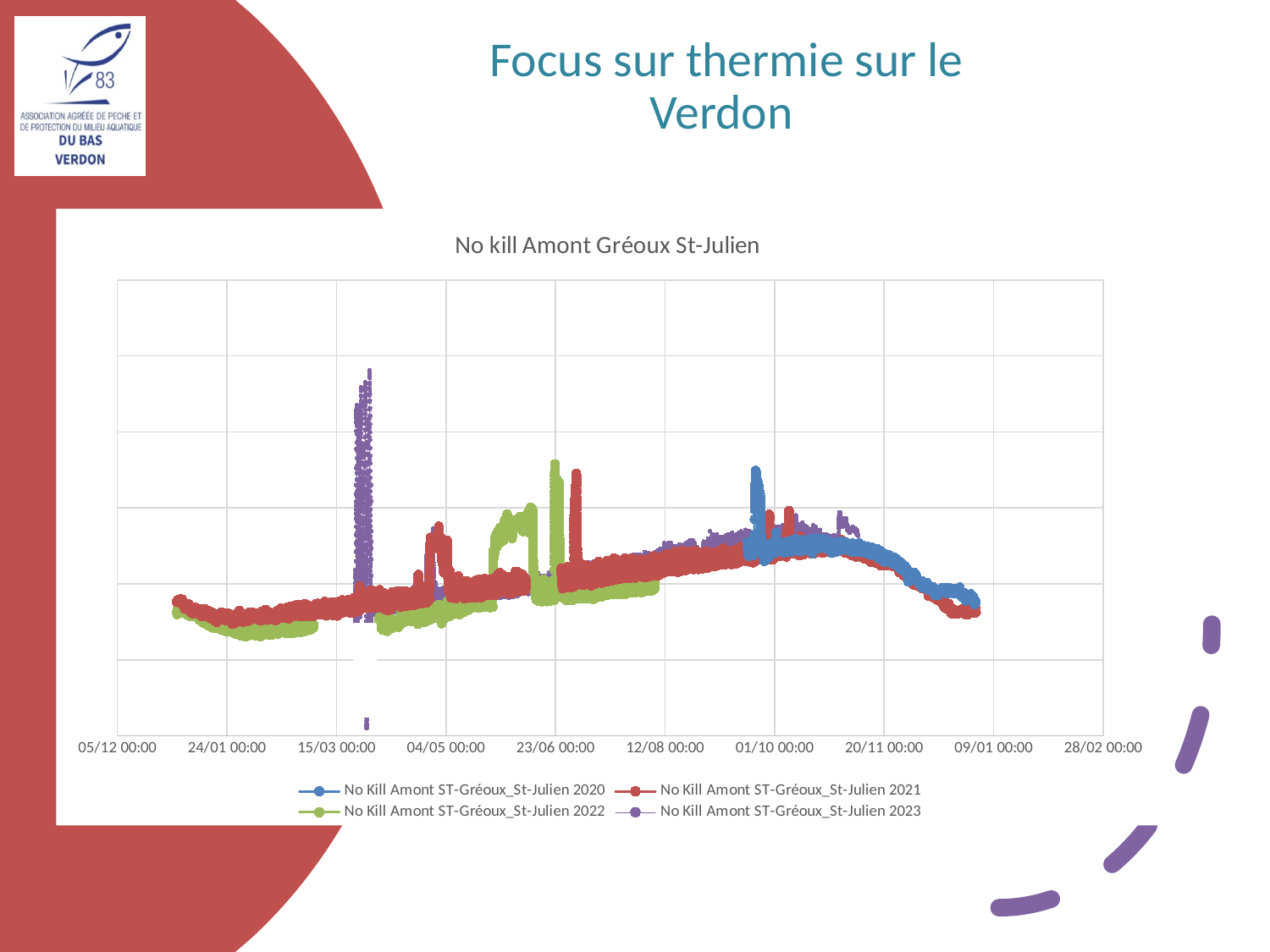
Which series reaches the highest peak on the chart? No Kill Amont ST-Gréoux_St-Julien 2023 Which colour is used for the series No Kill Amont ST-Gréoux_St-Julien 2023? Purple What kind of chart is shown on the slide? Line chart What is the first date label on the x axis? 05/12 00:00 How many series does the chart legend list? 4 Around which x-axis date does the tallest spike of the 2023 series occur? 15/03 00:00 Which series has the lowest plotted point on the chart? No Kill Amont ST-Gréoux_St-Julien 2023 Do the values of the No Kill Amont ST-Gréoux_St-Julien 2020 series rise or fall between 20/11 00:00 and 09/01 00:00? Fall What is the title of the chart? No kill Amont Gréoux St-Julien How many date labels are shown on the x axis? 10 Do the values of the No Kill Amont ST-Gréoux_St-Julien 2021 series generally rise or fall between 24/01 00:00 and 01/10 00:00? Rise What is the last date label on the x axis? 28/02 00:00